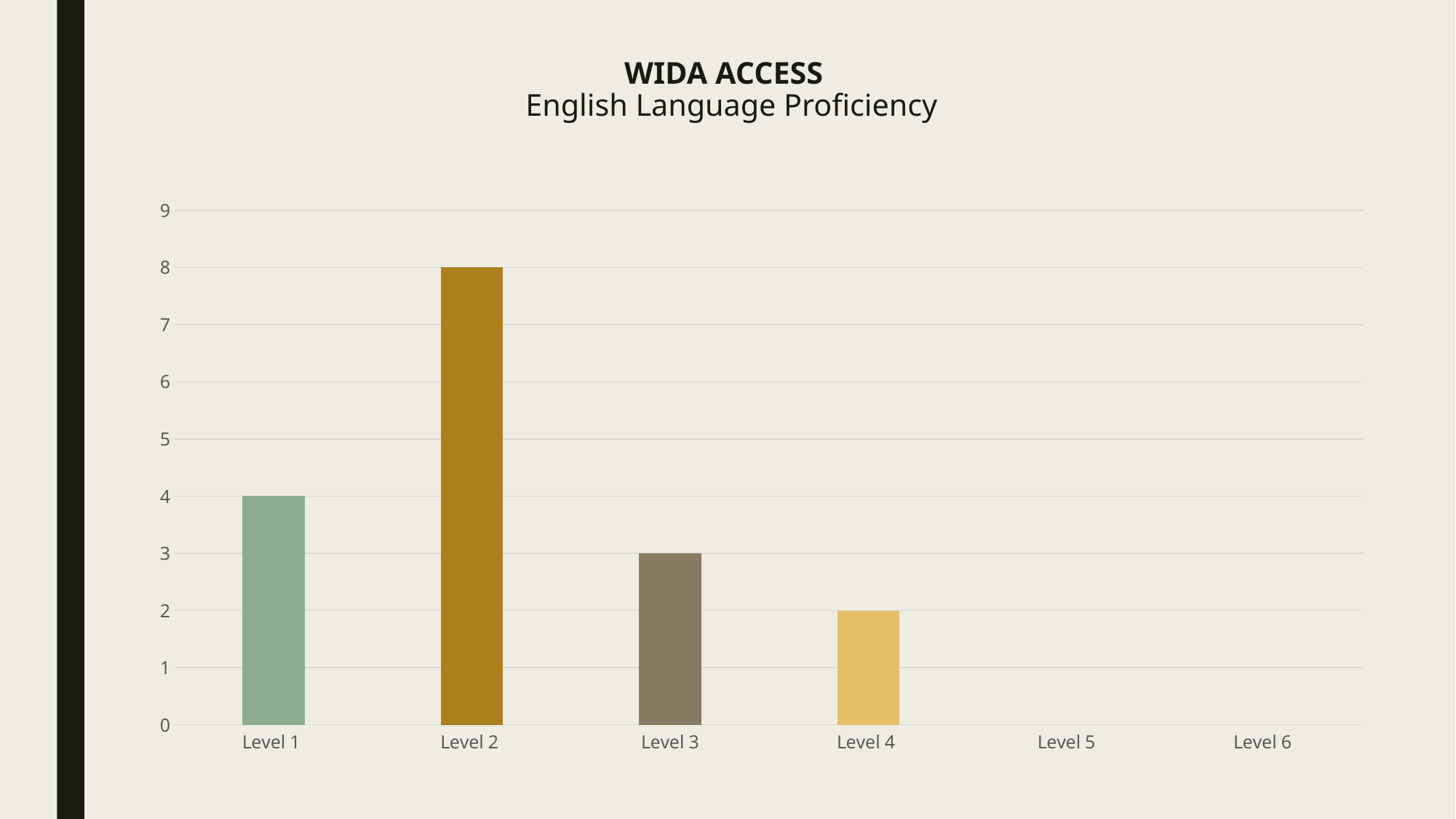
What is the value for Level 1? 4 Is the value for Level 2 greater or less than 5? greater What is the title of the chart? WIDA ACCESS English Language Proficiency What is the value for Level 2? 8 How many levels are shown on the x axis? 6 What is the difference between the values for Level 2 and Level 1? 4 Which is larger, the value for Level 1 or the value for Level 3? Level 1 What is the difference between the values for Level 3 and Level 4? 1 Which level has the highest value? Level 2 What is the value for Level 4? 2 What kind of chart is shown on the slide? bar chart Which level has the tallest bar among those with a visible bar, and which has the shortest visible bar? Level 2; Level 4